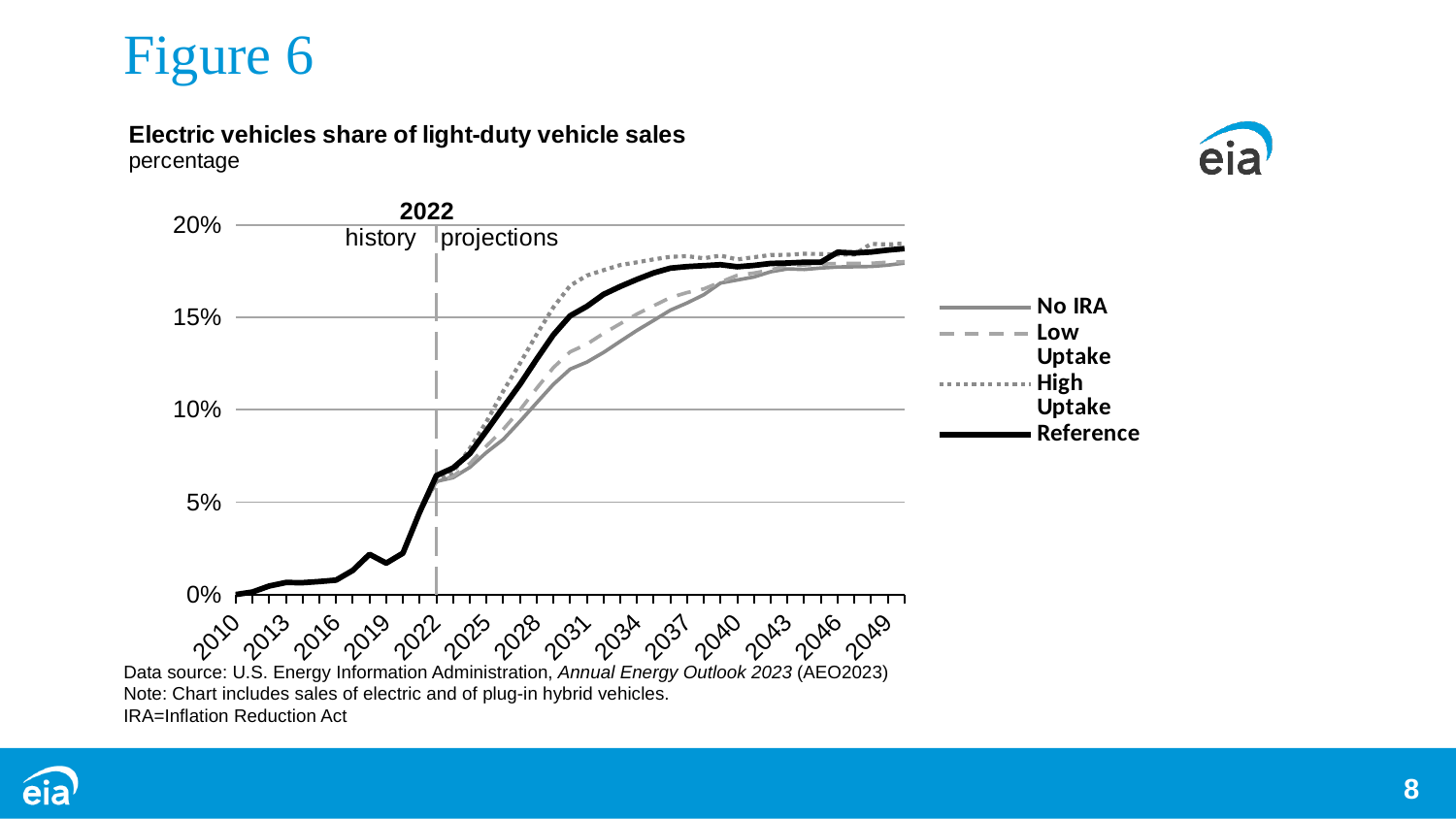
Which year does the vertical dashed line separating history from projections mark? 2022 Is the Reference value in 2019 greater or less than 5%? less Which series has the lowest value in 2031? No IRA What is the title of the chart? Electric vehicles share of light-duty vehicle sales Does the Reference series rise or fall from 2022 to 2049? rise What kind of chart is shown on the slide? line chart How many series does the legend list? 4 Is the Reference value in 2049 greater or less than 15%? greater Which series has the highest value in 2031? High Uptake Is the No IRA value in 2031 greater or less than 15%? less